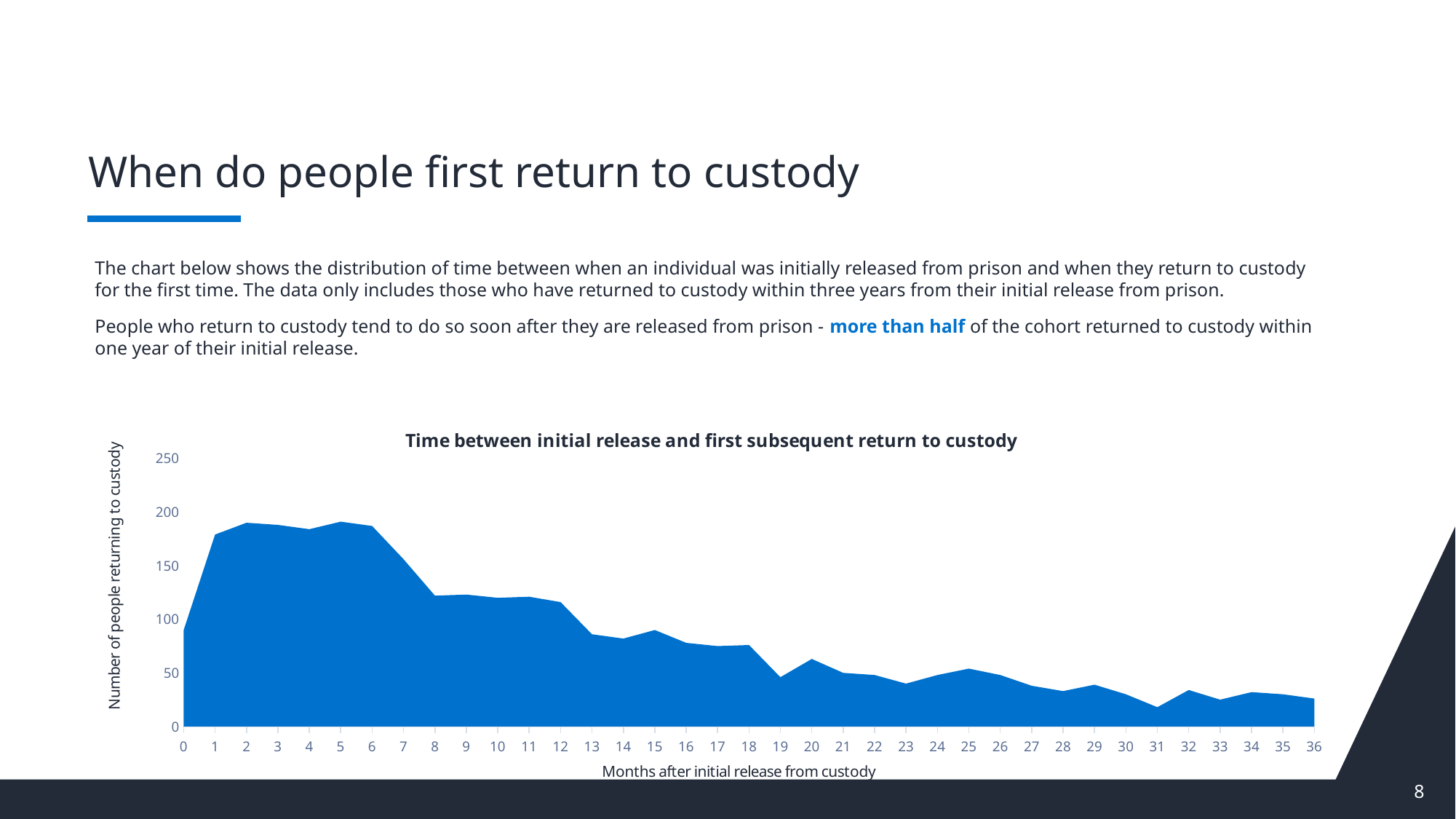
How many months are plotted along the x axis of the chart? 37 Is the value for month 8 greater or less than 100? greater Is the value for month 31 greater or less than 50? less What type of chart is shown on the slide? Area chart Is the value for month 2 greater or less than 150? greater Overall, do the values rise or fall as the months after initial release increase? Fall Which has a higher value, month 2 or month 20? Month 2 What is the title of the chart? Time between initial release and first subsequent return to custody What is the label of the x axis of the chart? Months after initial release from custody